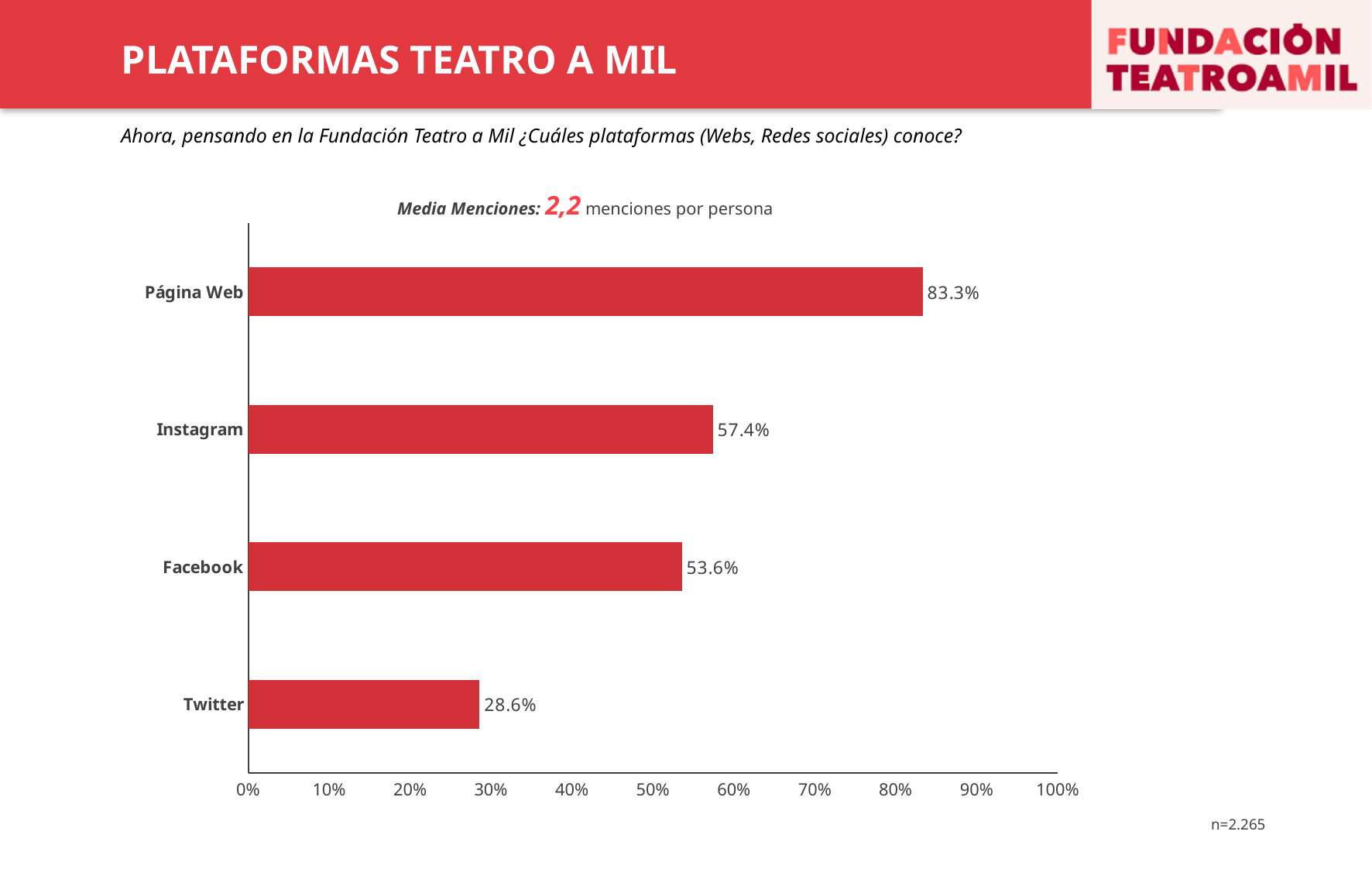
What is the value shown for Twitter? 28.6% What percentage of respondents know the Página Web platform? 83.3% Which platform has the lowest value? Twitter What is the difference between the values for Página Web and Twitter? 54.7% Which platform has the highest value? Página Web What is the difference between the values for Instagram and Facebook? 3.8% What is the value shown for Instagram? 57.4% Which has a larger value, Facebook or Twitter? Facebook What is the average number of mentions per person stated above the chart? 2,2 What kind of chart is shown on the slide? Bar chart How many platforms are shown in the chart? 4 Is the value for Facebook greater or less than 50%? greater